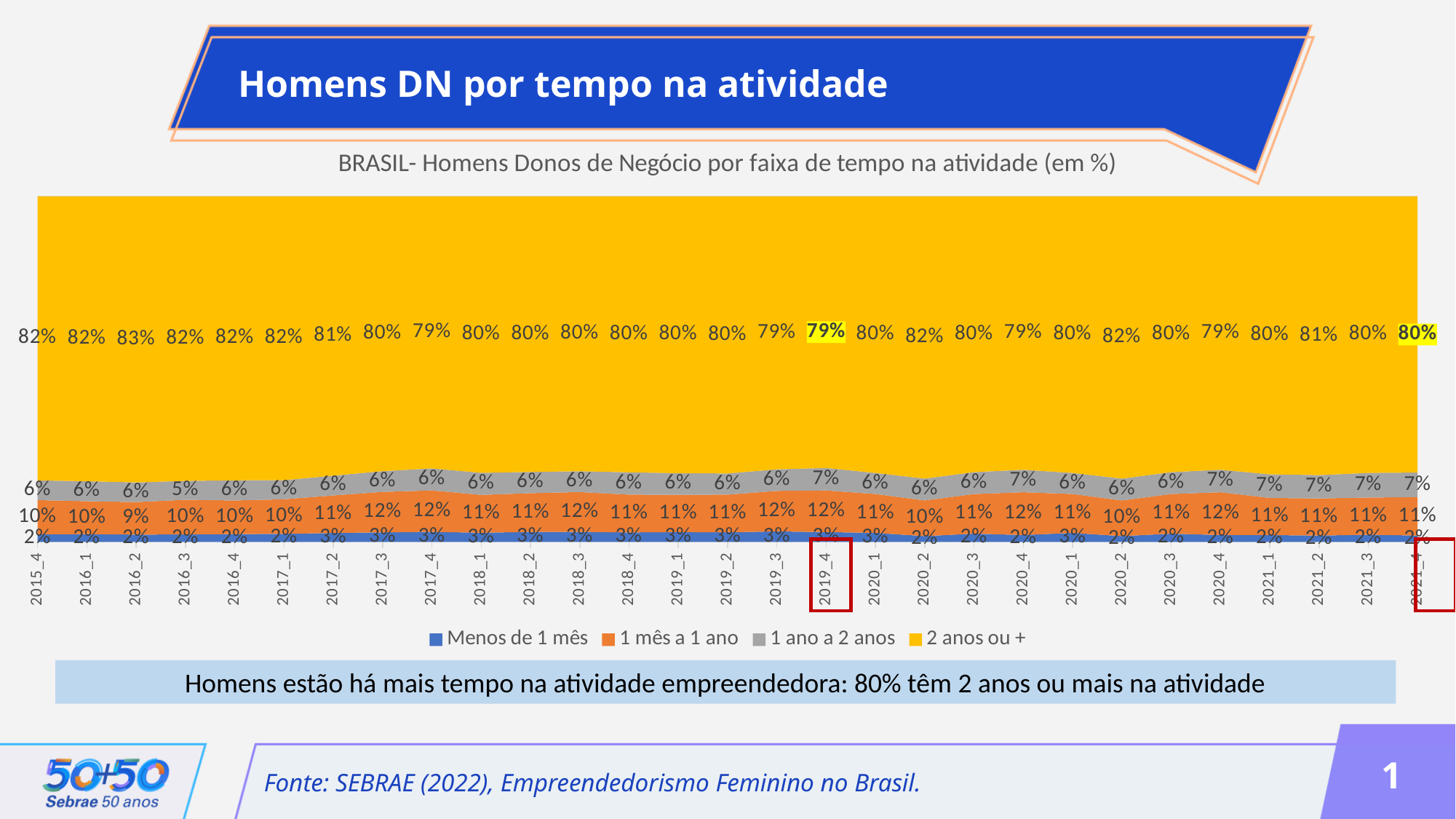
What is the value for '2 anos ou +' in 2015_4? 82% What type of chart is shown on the slide? Stacked area chart What is the value for '2 anos ou +' in 2021_4? 80% How many series does the legend list? 4 Which series has the smallest share across all periods? Menos de 1 mês What is the value for 'Menos de 1 mês' in 2015_4? 2% Which series has the largest share across all periods? 2 anos ou + What is the value for '1 ano a 2 anos' in 2021_4? 7% What is the title of the chart? BRASIL- Homens Donos de Negócio por faixa de tempo na atividade (em %) What is the value for '1 mês a 1 ano' in 2015_4? 10% By how many percentage points did the '2 anos ou +' share change from 2015_4 (82%) to 2021_4 (80%)? 2 percentage points lower What is the value for '2 anos ou +' in 2019_4? 79%